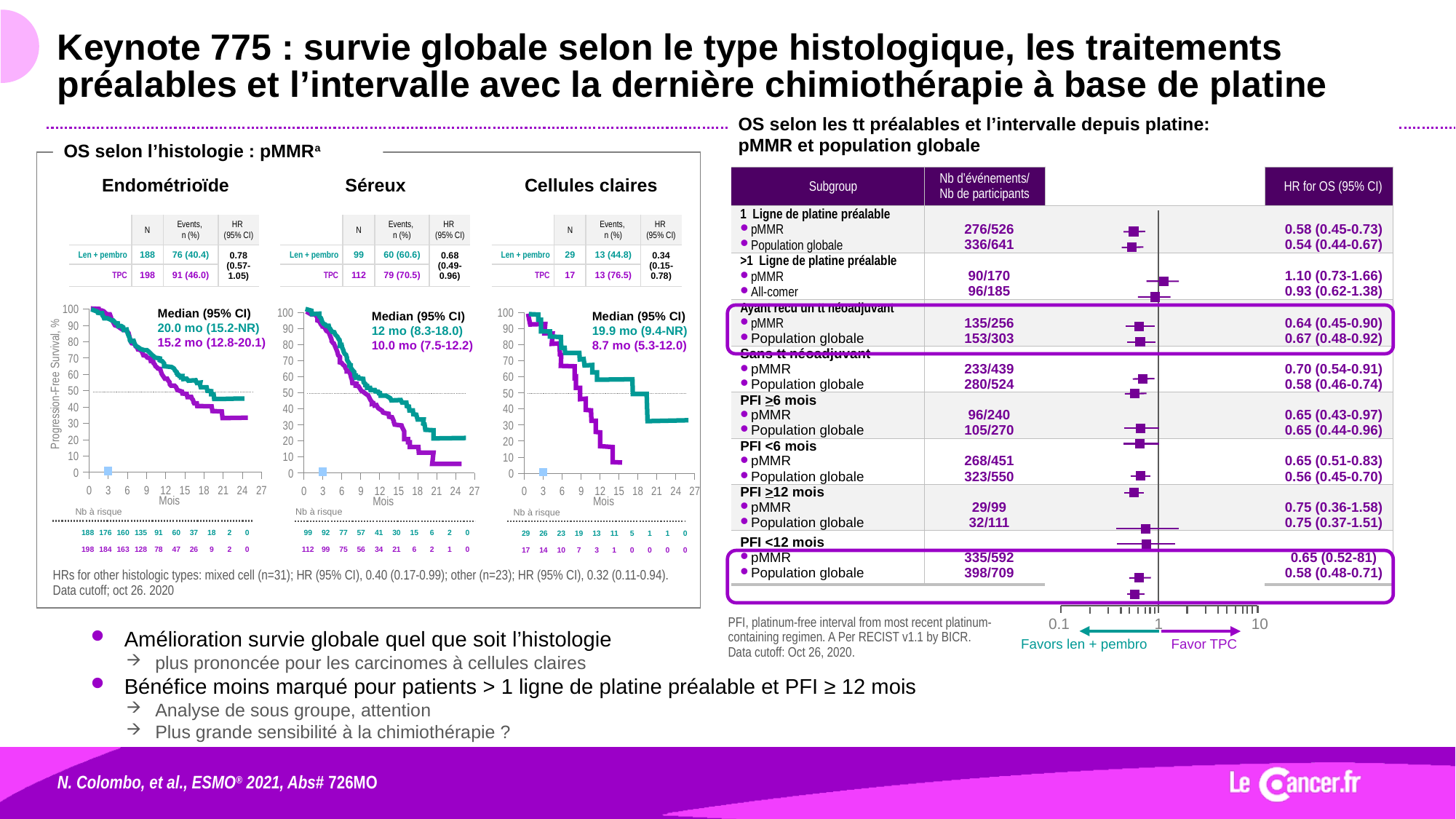
In the Endométrioïde chart, what is the median (95% CI) for the Len + pembro arm? 20.0 mo (15.2-NR) Among the three histology charts (Endométrioïde, Séreux, Cellules claires), which has the lowest HR? Cellules claires In the Endométrioïde chart, which arm has the higher median survival, Len + pembro or TPC? Len + pembro In the forest plot on the right, what is the HR for OS (95% CI) for pMMR patients with >1 ligne de platine préalable? 1.10 (0.73-1.66) In the forest plot on the right, is the HR for pMMR patients with 1 ligne de platine préalable greater or less than 1? less In the Cellules claires chart, what is the difference in median survival between the Len + pembro arm (19.9 mo) and the TPC arm (8.7 mo)? 11.2 mo In the forest plot on the right, which subgroup row has the highest HR for OS? >1 Ligne de platine préalable, pMMR In the Cellules claires chart, what is the HR (95% CI)? 0.34 (0.15-0.78) In the Séreux chart, what is the median for the TPC arm? 10.0 mo (7.5-12.2) In the forest plot on the right, what is the Nb d'événements/Nb de participants for Population globale with PFI <6 mois? 323/550 In the Séreux chart, how many patients (N) were in the TPC arm? 112 What type of chart are the three histology plots (Endométrioïde, Séreux, Cellules claires)? Line chart (Kaplan-Meier survival curves)